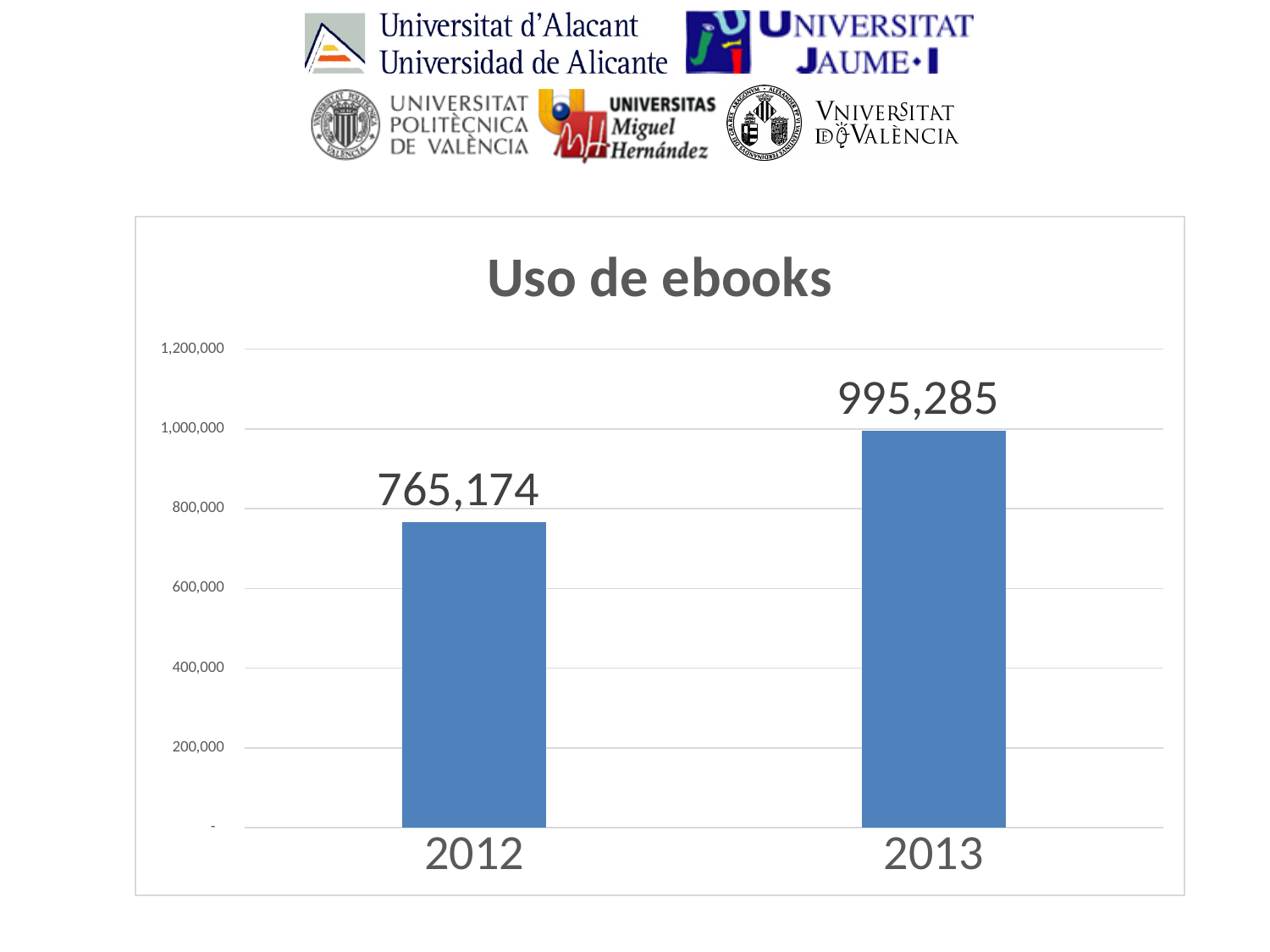
What kind of chart is 'Uso de ebooks'? bar chart Is the value for 2013 in the 'Uso de ebooks' chart greater or less than 1,000,000? less Which year has the highest value in the 'Uso de ebooks' chart? 2013 Which year has the lowest value in the 'Uso de ebooks' chart? 2012 Is the value for 2012 in the 'Uso de ebooks' chart greater or less than 600,000? greater What is the value for 2013 in the 'Uso de ebooks' chart? 995,285 What is the title of the chart on the slide? Uso de ebooks How many years are shown on the x axis of the 'Uso de ebooks' chart? 2 Do the values in the 'Uso de ebooks' chart rise or fall from 2012 to 2013? rise Which is larger in the 'Uso de ebooks' chart, the value for 2012 or the value for 2013? 2013 What is the difference between the 2013 and 2012 values in the 'Uso de ebooks' chart? 230,111 What is the value for 2012 in the 'Uso de ebooks' chart? 765,174